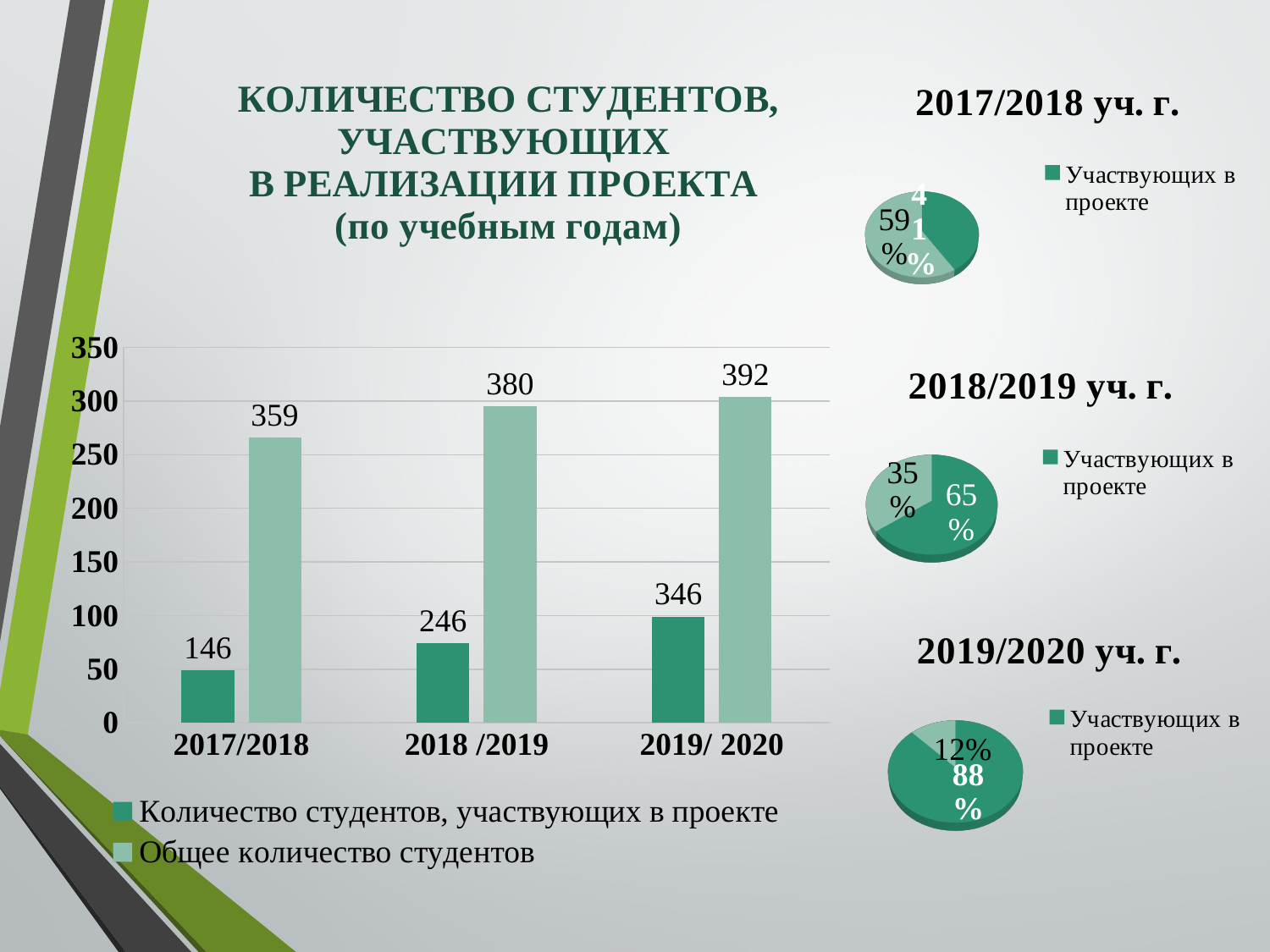
What kind of chart is the chart on the left of the slide? bar chart On the bar chart, how many series does the legend list? 2 On the bar chart, which year has the lowest number of students participating in the project? 2017/2018 On the bar chart, what is the difference between the total number of students and the number participating in the project in 2017/2018? 213 On the bar chart, which year has the highest total number of students (Общее количество студентов)? 2019/2020 On the pie chart titled 2018/2019 уч. г., what share is shown for the larger slice? 65% On the pie chart titled 2019/2020 уч. г., what share is shown for the smaller slice? 12% On the bar chart, what is the total number of students (Общее количество студентов) for 2018/2019? 380 How many pie charts are on the slide? 3 On the bar chart, what is the number of students participating in the project for 2019/2020? 346 On the bar chart, does the number of students participating in the project rise or fall from 2017/2018 to 2019/2020? rise On the bar chart, what is the number of students participating in the project (Количество студентов, участвующих в проекте) for 2017/2018? 146